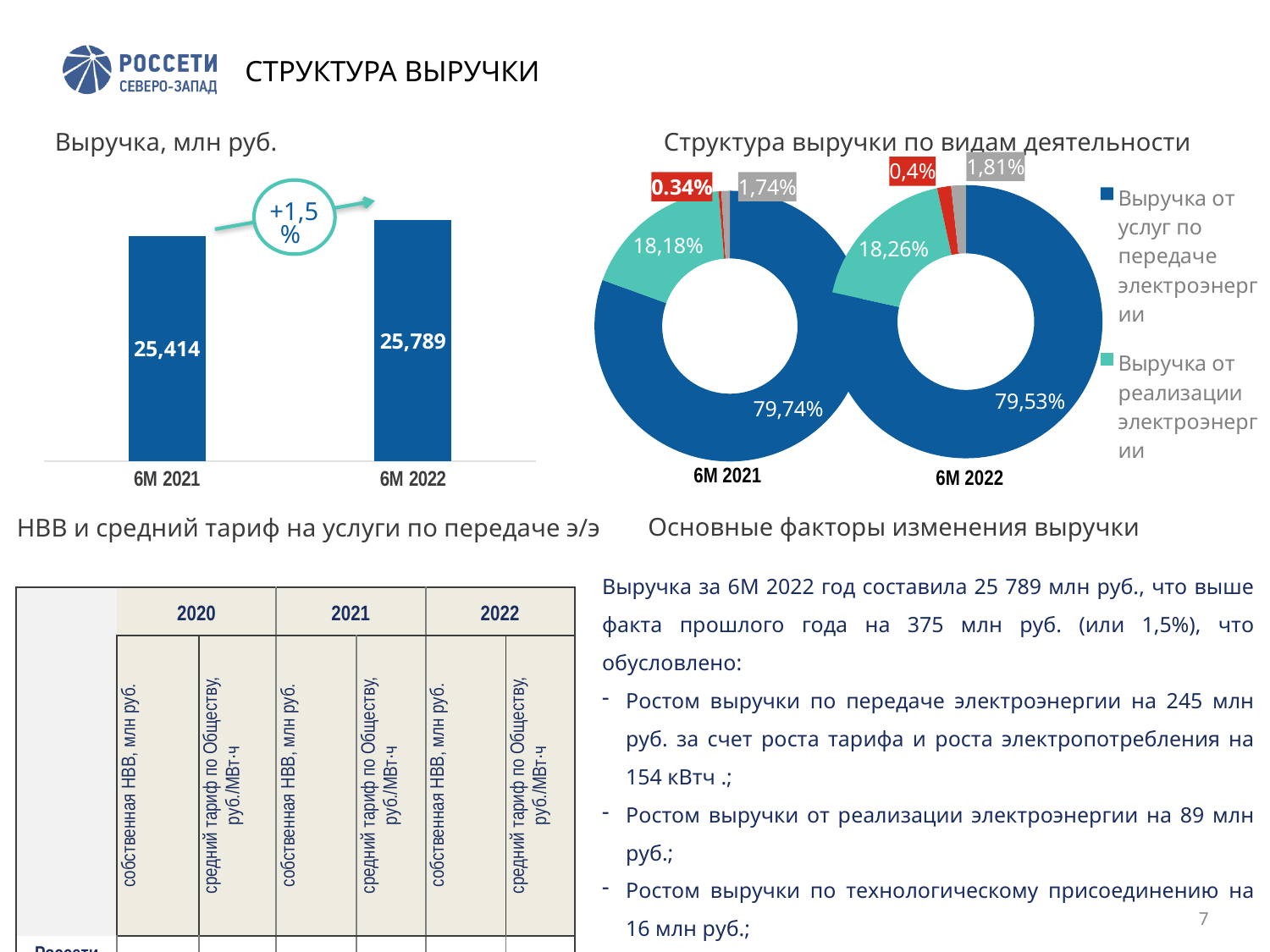
In the chart 'Структура выручки по видам деятельности', what share does 'Выручка от реализации электроэнергии' have in 6M 2022? 18,26% In the bar chart 'Выручка, млн руб.', what is the difference between the 6M 2022 and 6M 2021 values? 375 What kind of chart is 'Выручка, млн руб.'? Bar chart In the chart 'Структура выручки по видам деятельности', what is the largest slice in the 6M 2022 donut? 79,53% In the bar chart 'Выручка, млн руб.', how many bars are plotted? 2 What kind of chart is 'Структура выручки по видам деятельности'? Donut (pie) chart In the bar chart 'Выручка, млн руб.', what percentage change is shown between 6M 2021 and 6M 2022? +1,5% In the chart 'Структура выручки по видам деятельности', what share does 'Выручка от услуг по передаче электроэнергии' have in 6M 2021? 79,74% In the bar chart 'Выручка, млн руб.', what is the value for 6M 2022? 25,789 In the bar chart 'Выручка, млн руб.', which period has the higher value? 6M 2022 In the bar chart 'Выручка, млн руб.', what is the value for 6M 2021? 25,414 In the chart 'Структура выручки по видам деятельности', what is the smallest slice in the 6M 2021 donut? 0.34%